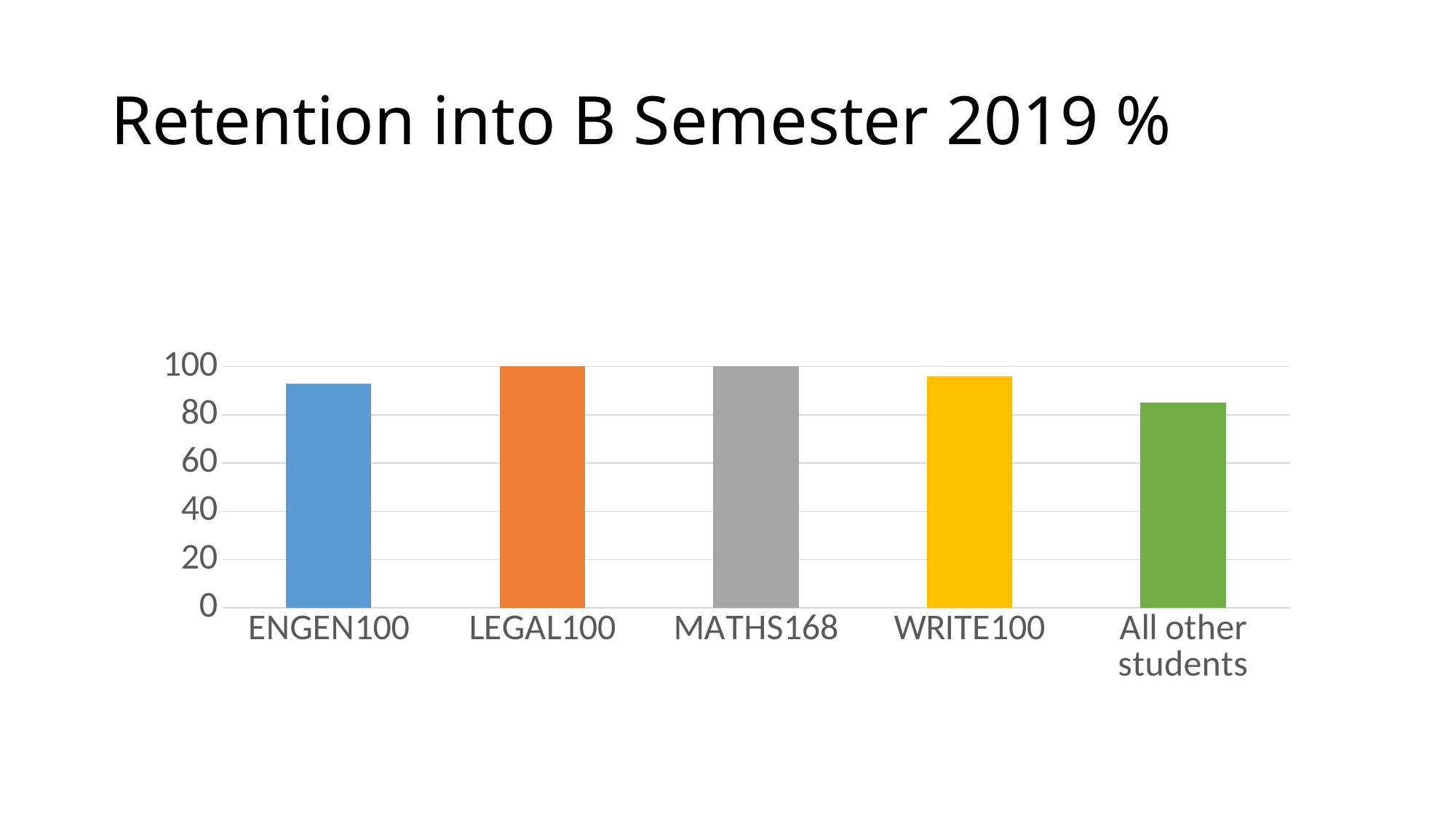
Which category has the lowest value? All other students Is the value for All other students greater or less than 100? less Which is larger, the value for LEGAL100 or the value for All other students? LEGAL100 What is the value for MATHS168? 100 What type of chart is shown on the slide? bar chart What is the title of the chart? Retention into B Semester 2019 % How many categories are shown on the x axis? 5 Is the value for ENGEN100 greater or less than 80? greater Is the value for WRITE100 greater or less than 80? greater Which is larger, the value for ENGEN100 or the value for All other students? ENGEN100 What is the value for LEGAL100? 100